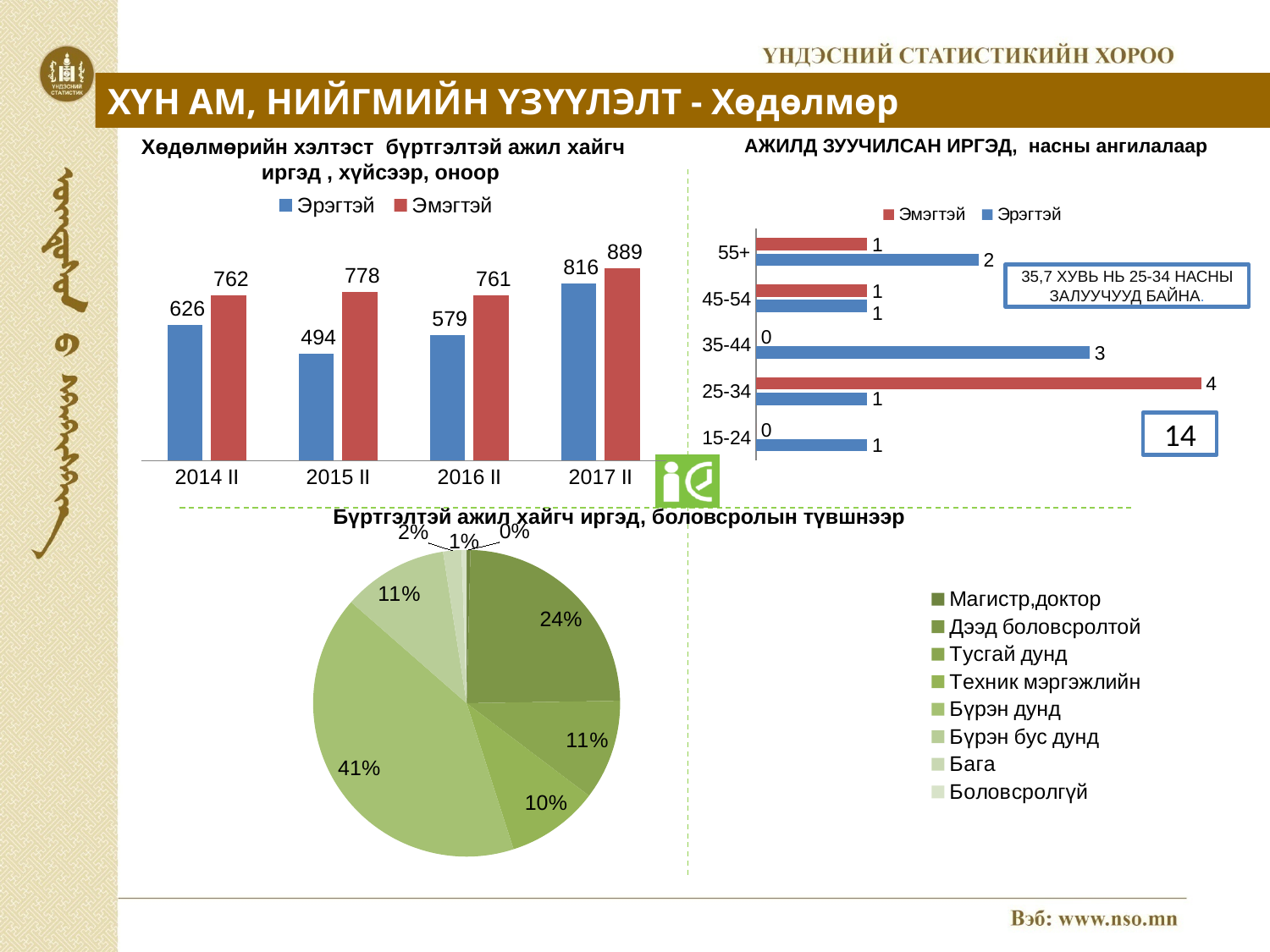
In the chart 'АЖИЛД ЗУУЧИЛСАН ИРГЭД, насны ангилалаар', what is the Эмэгтэй value for the 25-34 age group? 4 In the chart 'Хөдөлмөрийн хэлтэст бүртгэлтэй ажил хайгч иргэд, хүйсээр, оноор', what is the difference between the Эмэгтэй and Эрэгтэй values in 2016 II? 182 In the pie chart 'Бүртгэлтэй ажил хайгч иргэд, боловсролын түвшнээр', how many categories does the legend list? 8 In the chart 'Хөдөлмөрийн хэлтэст бүртгэлтэй ажил хайгч иргэд, хүйсээр, оноор', which year has the lowest Эрэгтэй value? 2015 II In the pie chart 'Бүртгэлтэй ажил хайгч иргэд, боловсролын түвшнээр', what is the share of the largest slice? 41% In the chart 'Хөдөлмөрийн хэлтэст бүртгэлтэй ажил хайгч иргэд, хүйсээр, оноор', how many year categories are shown on the x axis? 4 In the chart 'Хөдөлмөрийн хэлтэст бүртгэлтэй ажил хайгч иргэд, хүйсээр, оноор', what is the value for Эрэгтэй in 2014 II? 626 In the chart 'Хөдөлмөрийн хэлтэст бүртгэлтэй ажил хайгч иргэд, хүйсээр, оноор', what is the value for Эмэгтэй in 2017 II? 889 What type of chart is 'Хөдөлмөрийн хэлтэст бүртгэлтэй ажил хайгч иргэд, хүйсээр, оноор'? Bar chart In the chart 'АЖИЛД ЗУУЧИЛСАН ИРГЭД, насны ангилалаар', how many series does the legend list? 2 In the chart 'АЖИЛД ЗУУЧИЛСАН ИРГЭД, насны ангилалаар', what is the Эрэгтэй value for the 35-44 age group? 3 In the chart 'АЖИЛД ЗУУЧИЛСАН ИРГЭД, насны ангилалаар', which age group has the highest Эрэгтэй value? 35-44